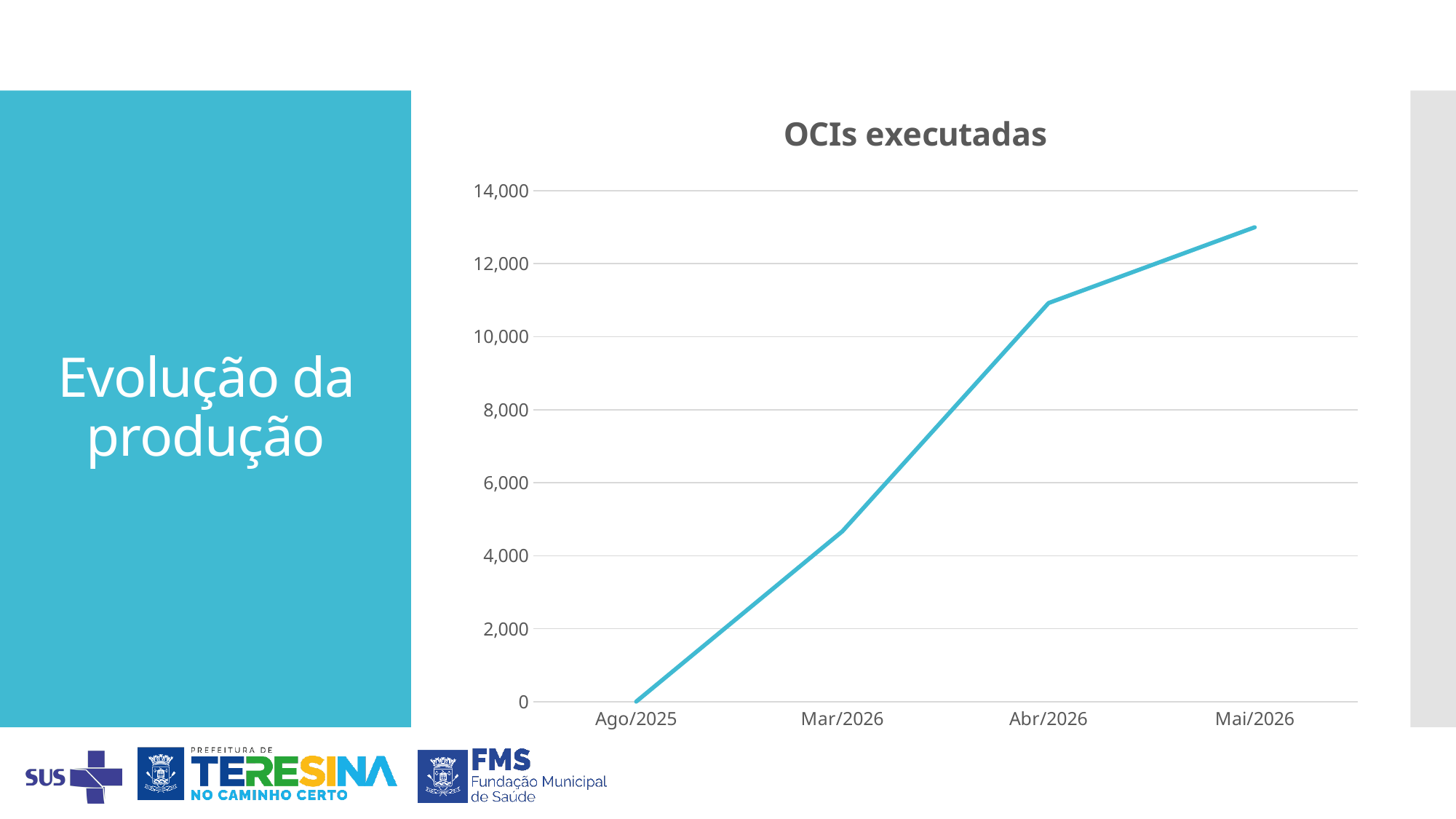
Is the value for Mar/2026 greater or less than 6,000? less Is the value for Mai/2026 greater or less than 12,000? greater What type of chart is shown on the slide? Line chart Do the values rise or fall from Ago/2025 to Mai/2026? Rise Is the value for Abr/2026 greater or less than 10,000? greater How many points are plotted on the x axis of the chart? 4 Which is larger, the value for Abr/2026 or the value for Mar/2026? Abr/2026 Which period has the lowest value? Ago/2025 Which period has the highest value? Mai/2026 What is the title of the chart? OCIs executadas